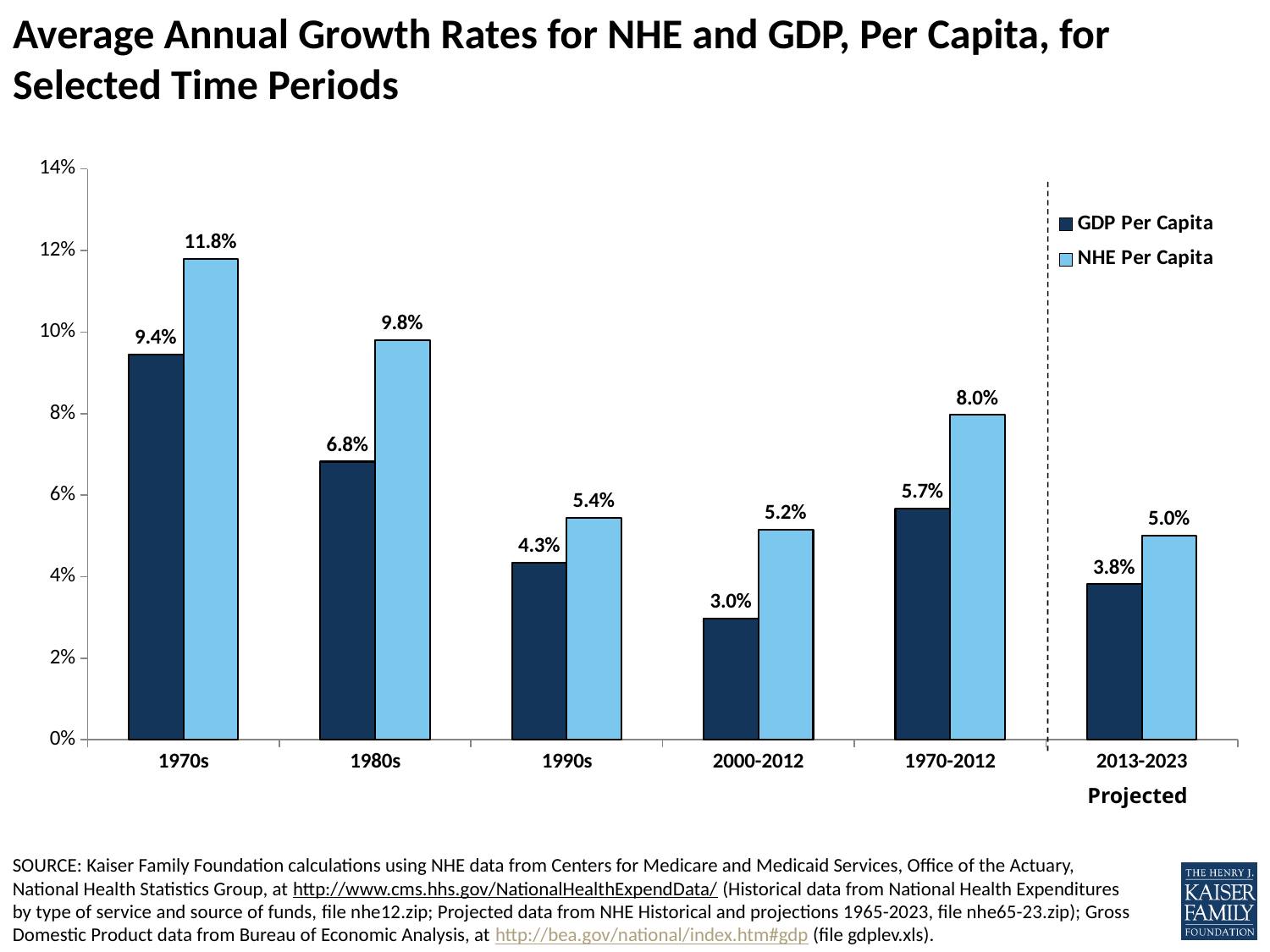
What kind of chart is shown on the slide? bar chart What is the projected NHE Per Capita growth rate for 2013-2023? 5.0% Which is larger for 1970-2012: the GDP Per Capita growth rate or the NHE Per Capita growth rate? NHE Per Capita What is the NHE Per Capita growth rate for the 1970s? 11.8% What is the difference between the NHE Per Capita and GDP Per Capita growth rates for the 1980s? 3.0% Which time period on the chart is labeled as projected? 2013-2023 What is the GDP Per Capita growth rate for 2000-2012? 3.0% Which time period has the lowest GDP Per Capita growth rate? 2000-2012 How many series does the legend list? 2 Which time period has the highest NHE Per Capita growth rate? 1970s Is the GDP Per Capita growth rate for the 1990s greater or less than 6%? less How many time periods are shown on the x axis? 6